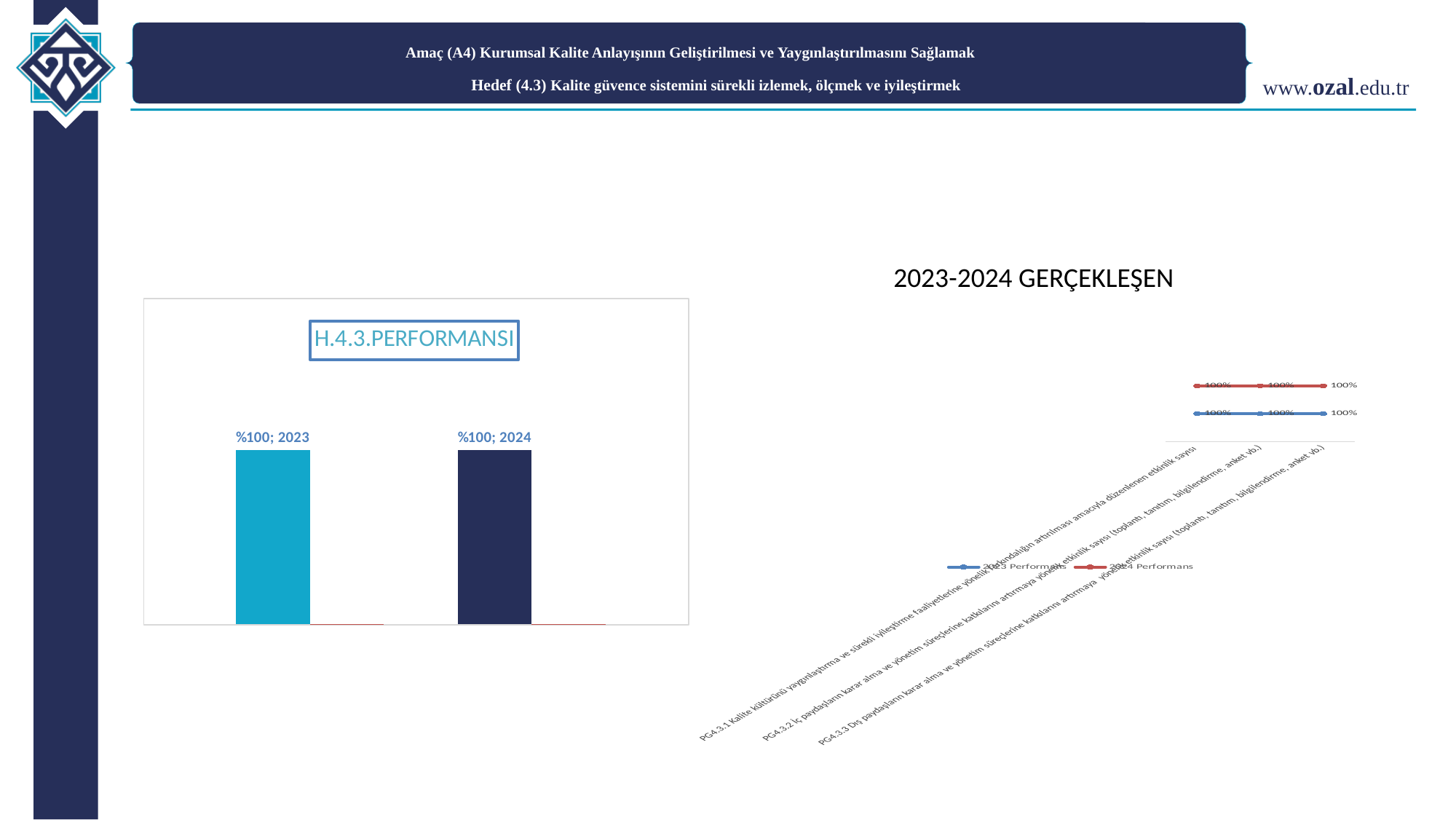
What kind of chart is the H.4.3.PERFORMANSI chart? bar chart On the H.4.3.PERFORMANSI chart, what colour is the 2023 bar? light blue On the H.4.3.PERFORMANSI chart, what is the value for 2023? %100 On the 2023-2024 GERÇEKLEŞEN chart, how many series does the legend list? 2 On the 2023-2024 GERÇEKLEŞEN chart, how many categories are shown on the x axis? 3 On the 2023-2024 GERÇEKLEŞEN chart, do the 2023 Performans values rise, fall or stay flat across the categories? stay flat On the H.4.3.PERFORMANSI chart, how many bars are plotted? 2 On the H.4.3.PERFORMANSI chart, what is the difference between the 2023 and 2024 values? 0 On the 2023-2024 GERÇEKLEŞEN chart, what is the 2024 Performans value for PG4.3.1? 100% On the 2023-2024 GERÇEKLEŞEN chart, what is the 2023 Performans value for PG4.3.3? 100% What kind of chart is the 2023-2024 GERÇEKLEŞEN chart? line chart On the H.4.3.PERFORMANSI chart, what is the value for 2024? %100